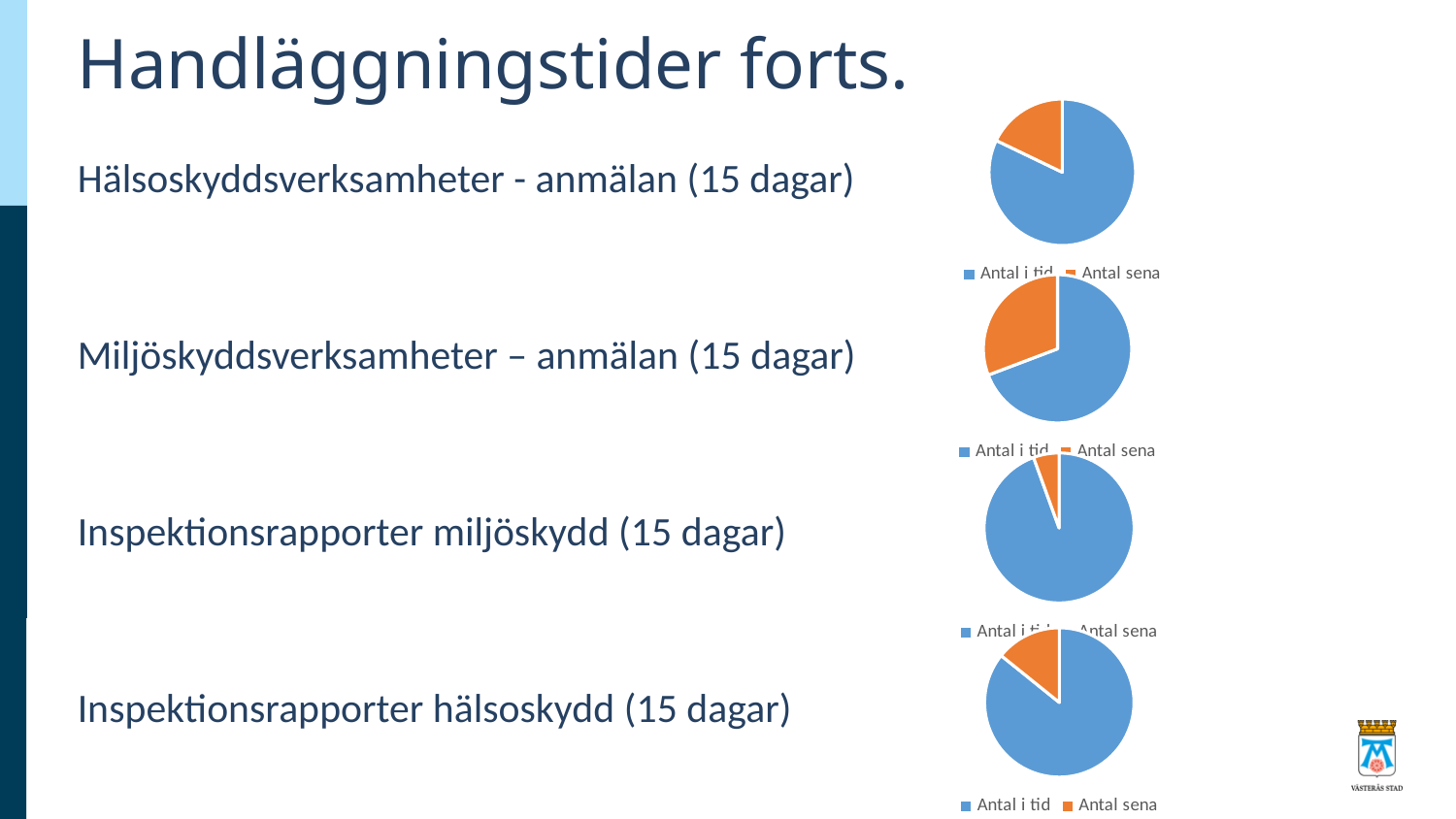
How many categories are plotted in the top pie chart? 2 How many pie charts are shown on the slide? 4 What kind of chart is the top chart on the right side of the slide? pie chart In the bottom pie chart, which category has the largest slice? Antal i tid In the second pie chart from the top, which category has the smallest slice? Antal sena How many entries does the legend of the bottom pie chart list? 2 What colour represents Antal i tid in the pie charts? blue Which of the four pie charts has the smallest Antal sena slice? the third from the top Which of the four pie charts has the largest Antal sena slice? the second from the top In the third pie chart from the top, which slice is larger, Antal i tid or Antal sena? Antal i tid What colour represents Antal sena in the pie charts? orange In the top pie chart, which category has the largest slice? Antal i tid